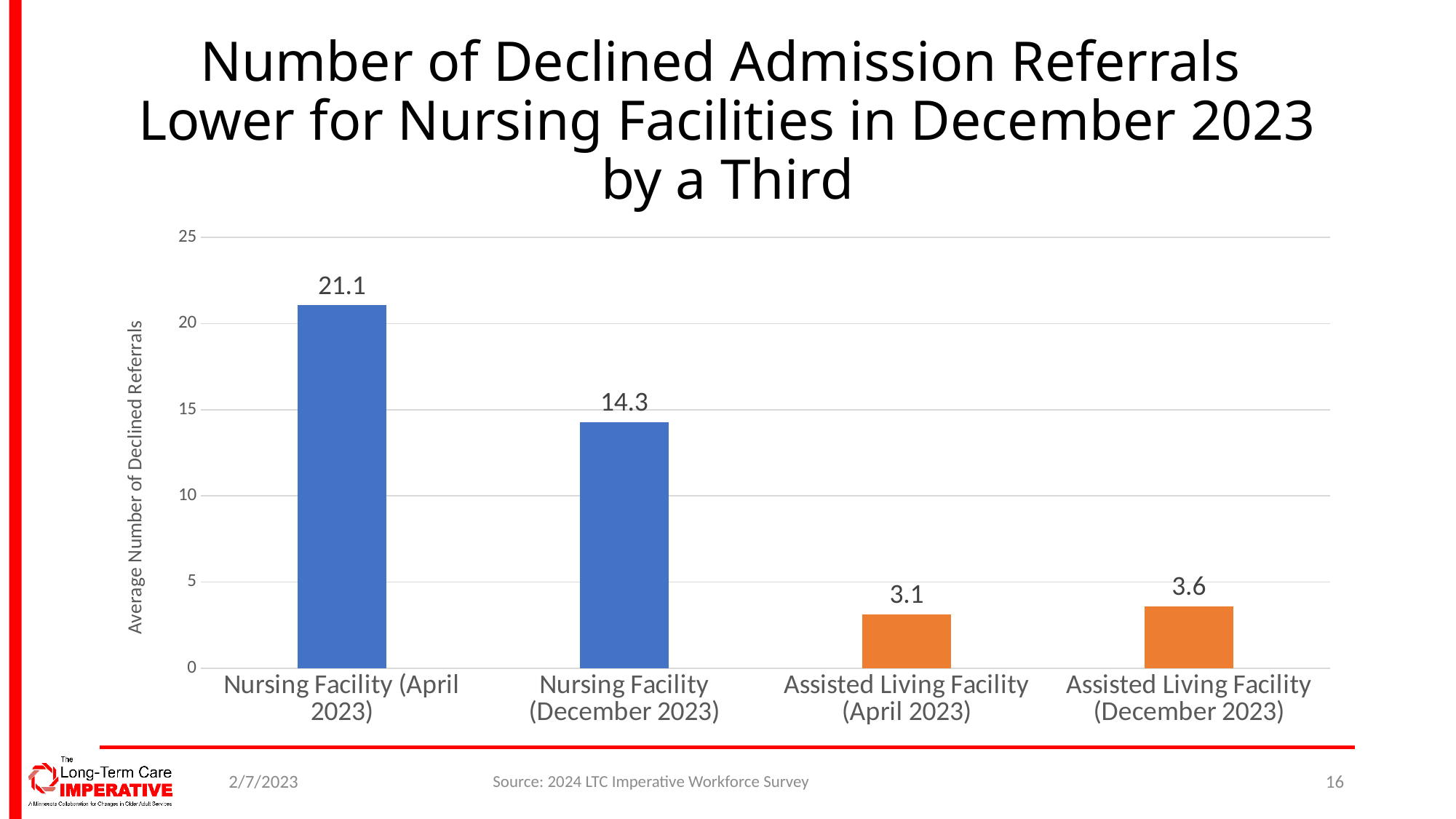
Which category has the lowest average number of declined referrals? Assisted Living Facility (April 2023) What is the average number of declined referrals for Nursing Facility (April 2023)? 21.1 What is the label of the vertical axis? Average Number of Declined Referrals What is the difference between the Nursing Facility values for April 2023 and December 2023? 6.8 What is the average number of declined referrals for Nursing Facility (December 2023)? 14.3 How many categories are shown on the x axis? 4 What is the average number of declined referrals for Assisted Living Facility (December 2023)? 3.6 What is the average number of declined referrals for Assisted Living Facility (April 2023)? 3.1 Which is larger: the value for Assisted Living Facility (April 2023) or Assisted Living Facility (December 2023)? Assisted Living Facility (December 2023) Is the value for Nursing Facility (December 2023) greater or less than 15? less Which category has the highest average number of declined referrals? Nursing Facility (April 2023) What kind of chart is shown on the slide? Bar chart